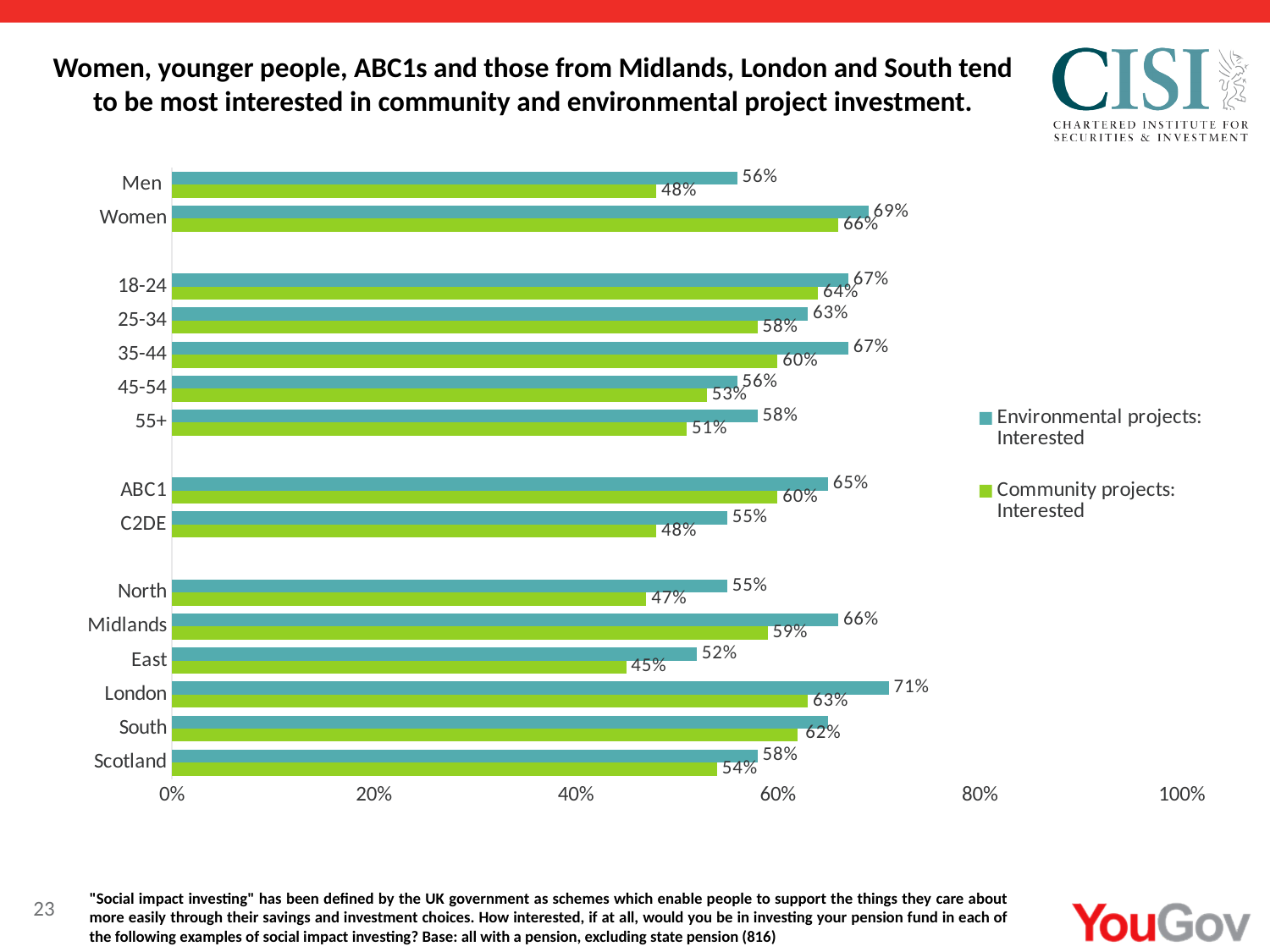
How many series does the legend list? 2 What is the value for Scotland in the Community projects: Interested series? 54% Is the Environmental projects value for London greater or less than 60%? greater Which category has the highest value in the Environmental projects: Interested series? London What type of chart is shown on the slide? Bar chart What is the value for London in the Environmental projects: Interested series? 71% Which category has the lowest value in the Community projects: Interested series? East What is the difference between the Environmental projects and Community projects values for Men? 8% What colour are the bars for the Community projects: Interested series? Green What is the value for Men in the Community projects: Interested series? 48% Which is larger: the Environmental projects value for Women or for 18-24? Women How many categories are shown on the vertical axis? 15